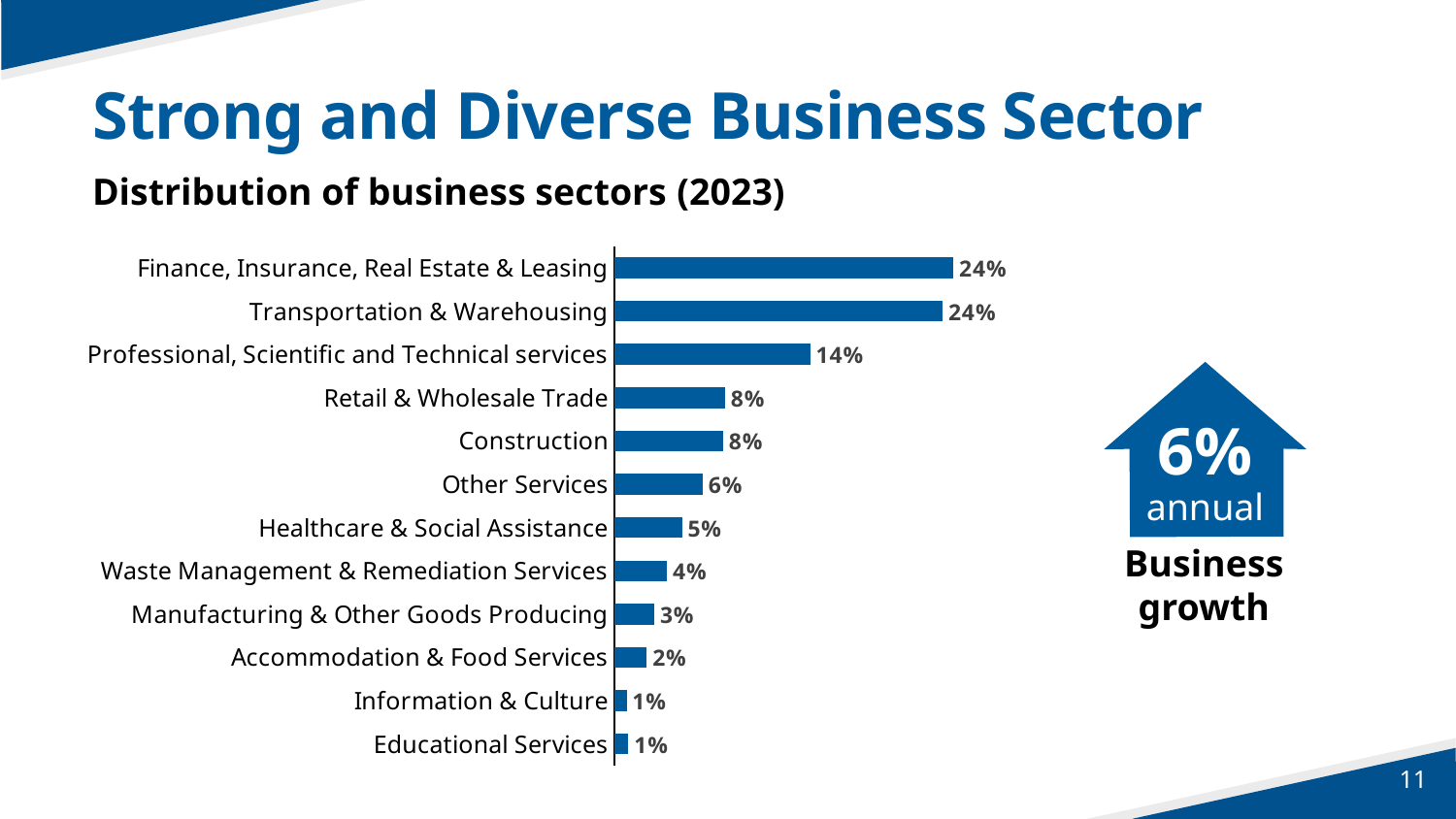
Which has a larger value, Transportation & Warehousing or Professional, Scientific and Technical services? Transportation & Warehousing What is the difference between the values for Other Services and Manufacturing & Other Goods Producing? 3% What value is shown for Finance, Insurance, Real Estate & Leasing? 24% Which has a larger value, Waste Management & Remediation Services or Other Services? Other Services What is the value for Construction in the distribution of business sectors chart? 8% What kind of chart is used to show the distribution of business sectors? Bar chart What is the difference between the values for Professional, Scientific and Technical services and Retail & Wholesale Trade? 6% What share is shown for Healthcare & Social Assistance? 5% What percentage is shown for Accommodation & Food Services? 2% How many business sectors are shown in the chart? 12 What is the title of the chart on the slide? Distribution of business sectors (2023) What percentage does the chart show for Professional, Scientific and Technical services? 14%